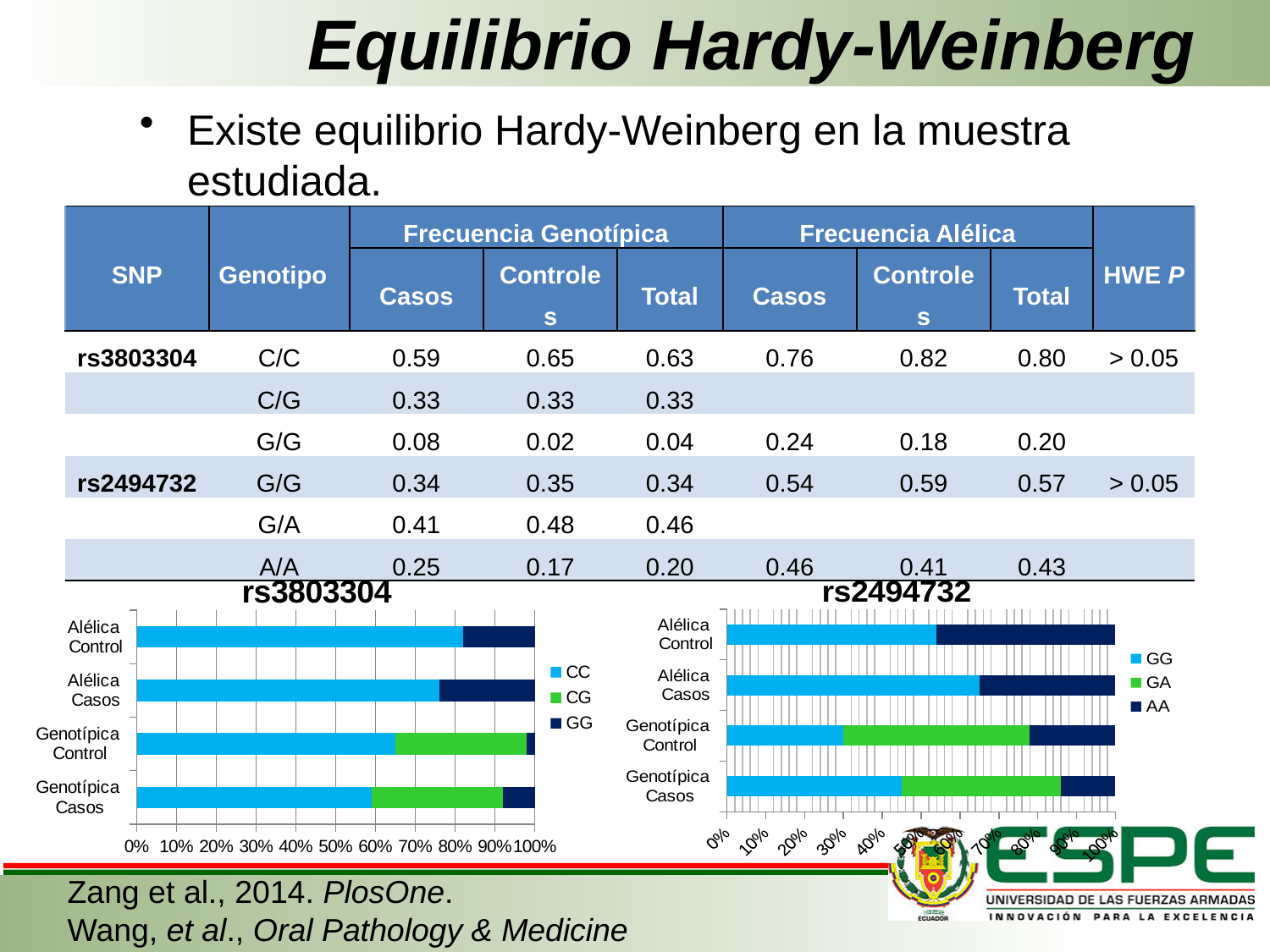
What kind of chart is the rs3803304 chart on the left? Stacked bar chart In the rs3803304 chart, is the CC value for Genotípica Casos greater or less than 50%? greater In the rs2494732 chart, is the GG value for Genotípica Casos greater or less than 50%? less In the rs2494732 chart, is the GG value for Alélica Control greater or less than 50%? greater What are the legend entries of the rs2494732 chart? GG, GA, AA How many categories are shown on the y axis of the rs2494732 chart on the right? 4 How many series does the legend of the rs3803304 chart list? 3 In the rs3803304 chart, which category has the smallest GG segment? Genotípica Control What is the title of the chart on the left of the slide? rs3803304 In the rs2494732 chart, which is larger: the AA segment for Alélica Casos or the AA segment for Genotípica Control? Alélica Casos In the rs3803304 chart, which is larger: the CC segment for Alélica Control or the CC segment for Genotípica Casos? Alélica Control